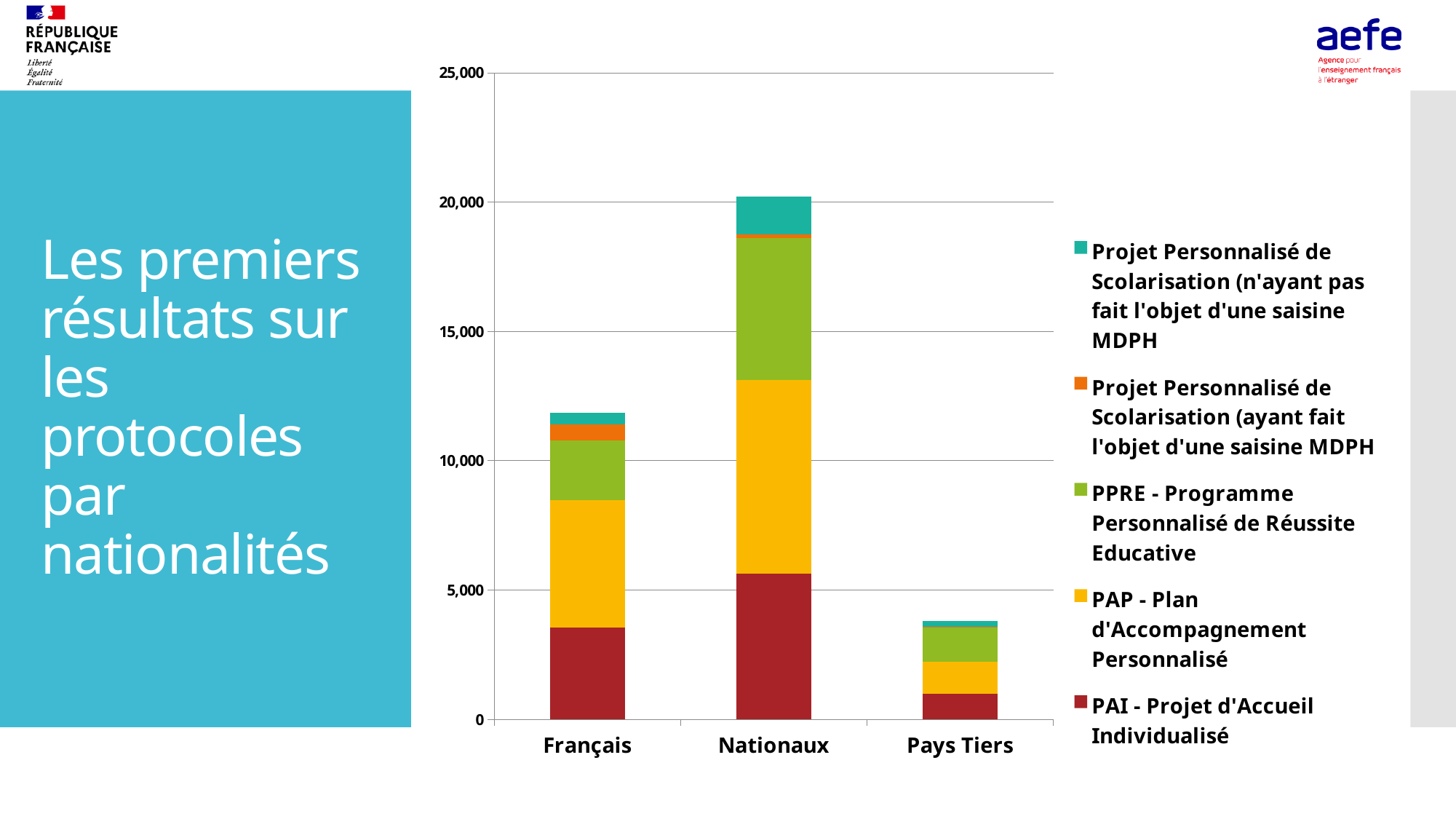
Is the total of the stacked bar for Pays Tiers greater or less than 5,000? less How many categories are shown on the x axis of the chart? 3 What kind of chart is shown on the slide? stacked bar chart Is the PAI - Projet d'Accueil Individualisé value for Nationaux greater or less than 5,000? greater Is the total of the stacked bar for Français greater or less than 15,000? less Which category has the tallest stacked bar? Nationaux Which category has the shortest stacked bar? Pays Tiers What colour represents PAP - Plan d'Accompagnement Personnalisé in the chart? yellow Which stacked bar is taller, Français or Pays Tiers? Français Which series is shown at the bottom of each stacked bar? PAI - Projet d'Accueil Individualisé How many series does the chart's legend list? 5